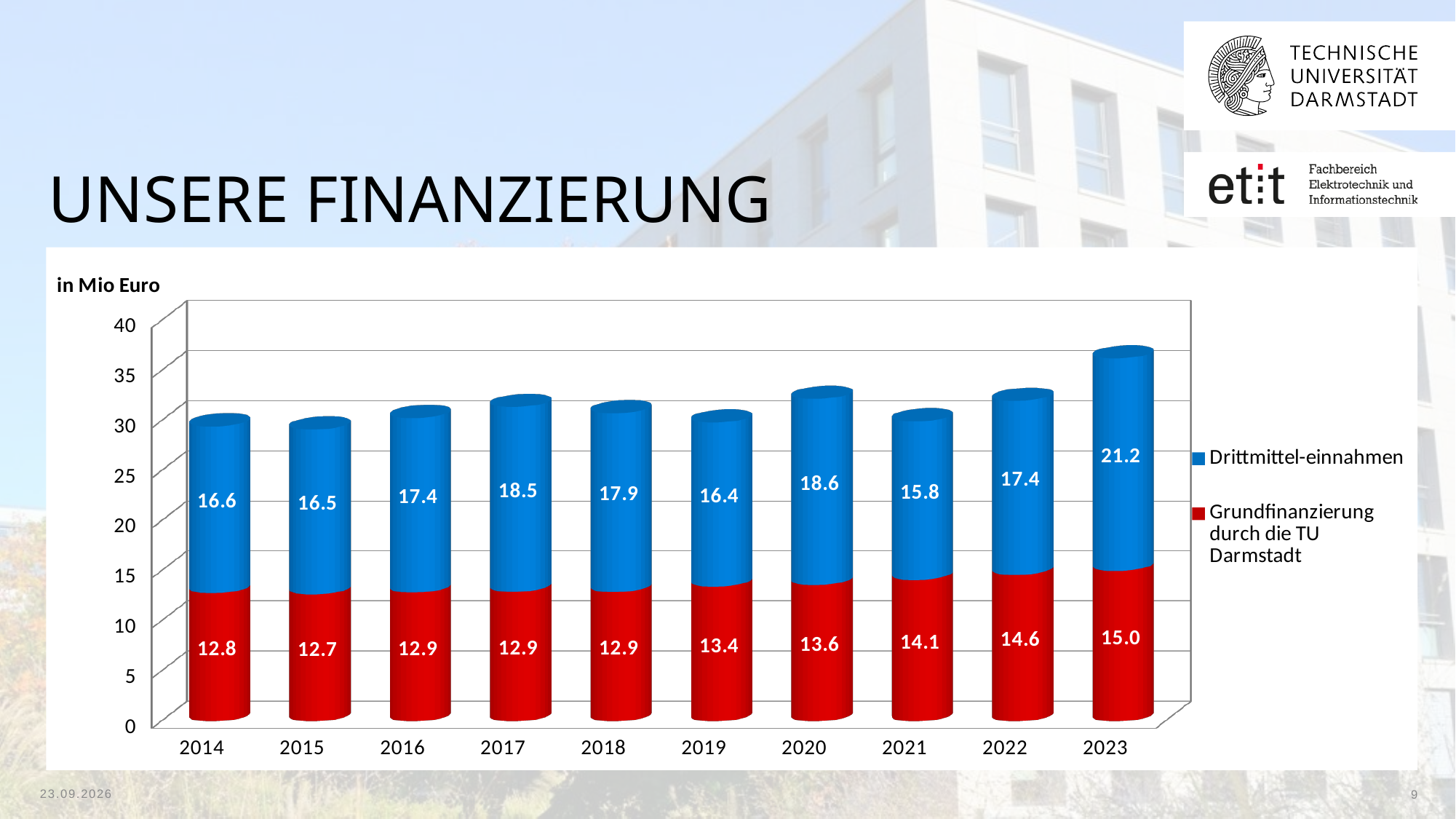
How many series does the legend list? 2 Which year has the lowest Grundfinanzierung durch die TU Darmstadt value? 2015 Which year has the highest Drittmittel-einnahmen value? 2023 Which is larger, the Drittmittel-einnahmen value for 2017 or for 2019? 2017 What kind of chart is shown on the slide? Stacked bar chart Does the Grundfinanzierung durch die TU Darmstadt value rise or fall from 2018 to 2023? Rise What unit is stated above the chart? in Mio Euro What is the Drittmittel-einnahmen value for 2023? 21.2 What is the Grundfinanzierung durch die TU Darmstadt value for 2014? 12.8 How many years are shown on the x axis? 10 What is the total of the stacked bar for 2023? 36.2 What is the difference between the Drittmittel-einnahmen values for 2023 and 2022? 3.8